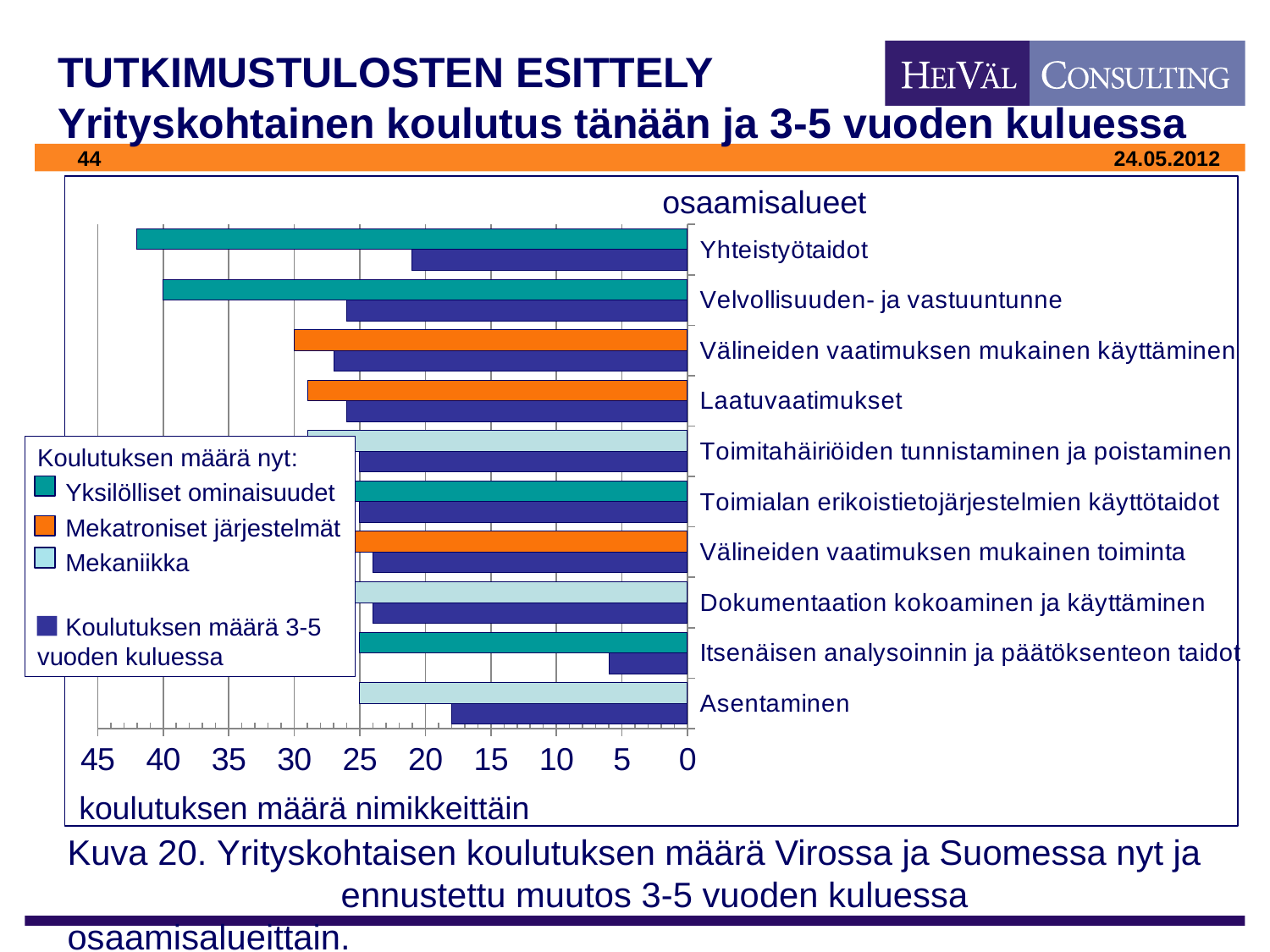
Is the current training amount for Yhteistyötaidot greater or less than 35? greater Which colour represents Mekatroniset järjestelmät in the legend? orange How many competence areas (categories) are listed on the chart? 10 What is the label shown below the horizontal axis of the chart? koulutuksen määrä nimikkeittäin Is the training amount in 3-5 years for Itsenäisen analysoinnin ja päätöksenteon taidot greater or less than 10? less For Asentaminen, which is larger: the current training amount or the amount in 3-5 years? the current training amount What kind of chart is shown on the slide? bar chart Which competence area has the highest current training amount (Koulutuksen määrä nyt)? Yhteistyötaidot Which competence area has the lowest training amount in 3-5 years (Koulutuksen määrä 3-5 vuoden kuluessa)? Itsenäisen analysoinnin ja päätöksenteon taidot Is the training amount in 3-5 years for Yhteistyötaidot greater or less than 25? less How many entries does the chart legend list? 4